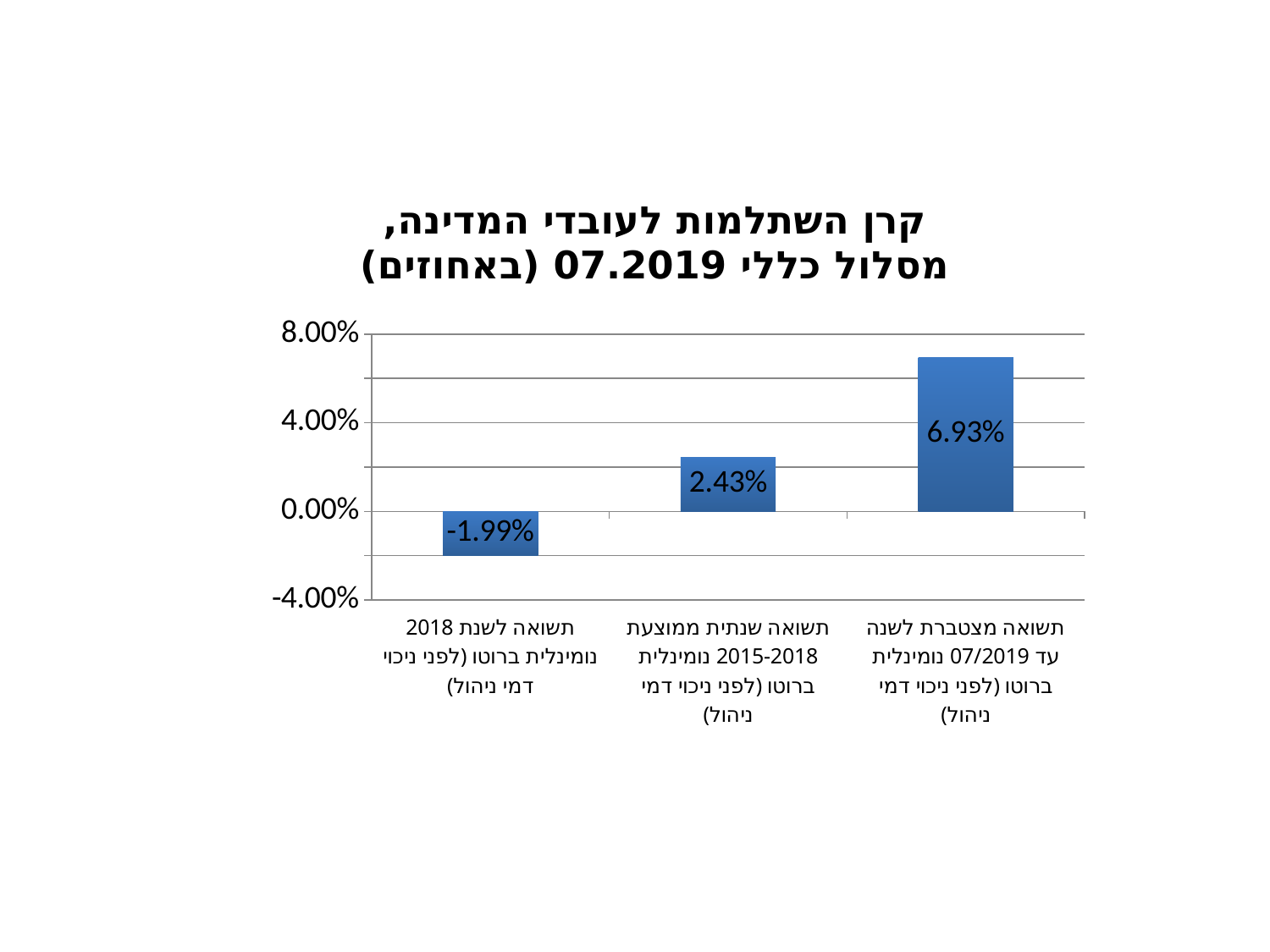
Which category has the lowest value? תשואה לשנת 2018 נומינלית ברוטו (לפני ניכוי דמי ניהול) What is the title of the chart? קרן השתלמות לעובדי המדינה, מסלול כללי 07.2019 (באחוזים) What is the value for the 2018 nominal gross return (תשואה לשנת 2018)? -1.99% Which category has the highest value? תשואה מצטברת לשנה עד 07/2019 נומינלית ברוטו (לפני ניכוי דמי ניהול) Which is larger: the average annual return 2015-2018 or the 2018 return? The average annual return 2015-2018 (2.43%) What is the value for the average annual nominal gross return 2015-2018 (תשואה שנתית ממוצעת 2015-2018)? 2.43% What is the difference between the cumulative return to 07/2019 and the average annual return 2015-2018? 4.50% Do the values rise or fall from left to right across the categories? Rise How many categories are shown in the chart? 3 What kind of chart is shown on the slide? Bar chart What is the value for the cumulative return for the year to 07/2019 (תשואה מצטברת לשנה עד 07/2019)? 6.93% Is the value for the cumulative return to 07/2019 greater or less than 4.00%? greater